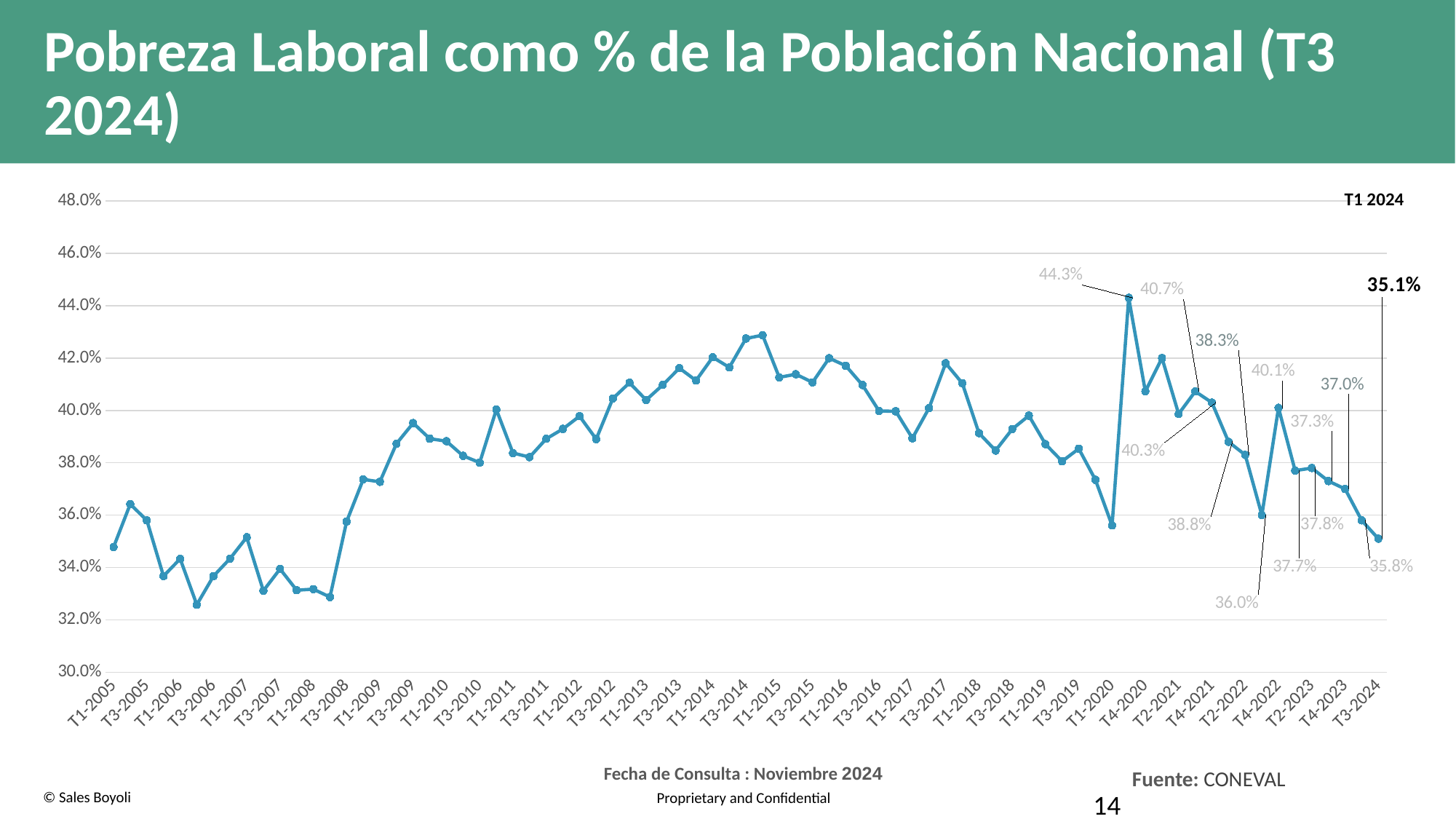
What is the highest value plotted on the chart? 44.3% Is the value for T3-2014 greater or less than 42.0%? greater What is the title of the chart on the slide? Pobreza Laboral como % de la Población Nacional (T3 2024) What is the difference between the peak value of 44.3% and the T3-2024 value of 35.1%? 9.2 percentage points What kind of chart is shown on the slide? line chart What source is cited for the chart data? CONEVAL What is the value for T3-2024, the last point on the chart? 35.1% Which is larger: the peak value labelled 44.3% or the T3-2024 value? the peak value of 44.3% Is the value for T3-2006 greater or less than 34.0%? less Is the value for T1-2009 greater or less than 36.0%? greater Does the line generally rise or fall from the 44.3% peak to T3-2024? fall